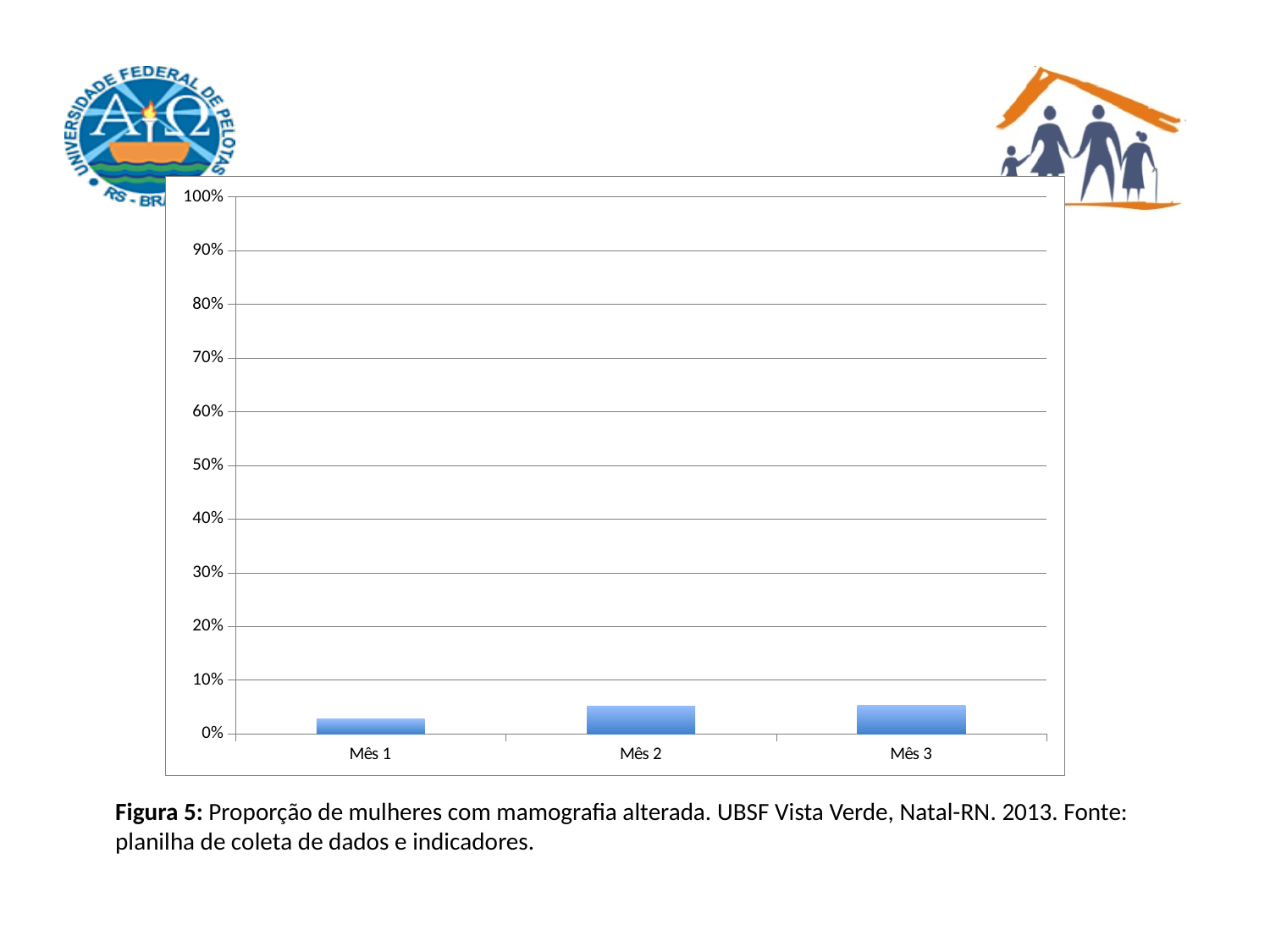
Which is larger, the value for Mês 1 or the value for Mês 2? Mês 2 Is the value for Mês 3 greater or less than 20%? less Which month has the lowest value? Mês 1 How many categories (months) are plotted on the x axis? 3 What kind of chart is shown on the slide? bar chart Which is larger, the value for Mês 1 or the value for Mês 3? Mês 3 According to the caption, which figure number is this chart? Figura 5 What is the highest value shown on the y axis? 100% Is the value for Mês 2 greater or less than 10%? less Is the value for Mês 1 greater or less than 10%? less Does the value rise or fall from Mês 1 to Mês 2? rise